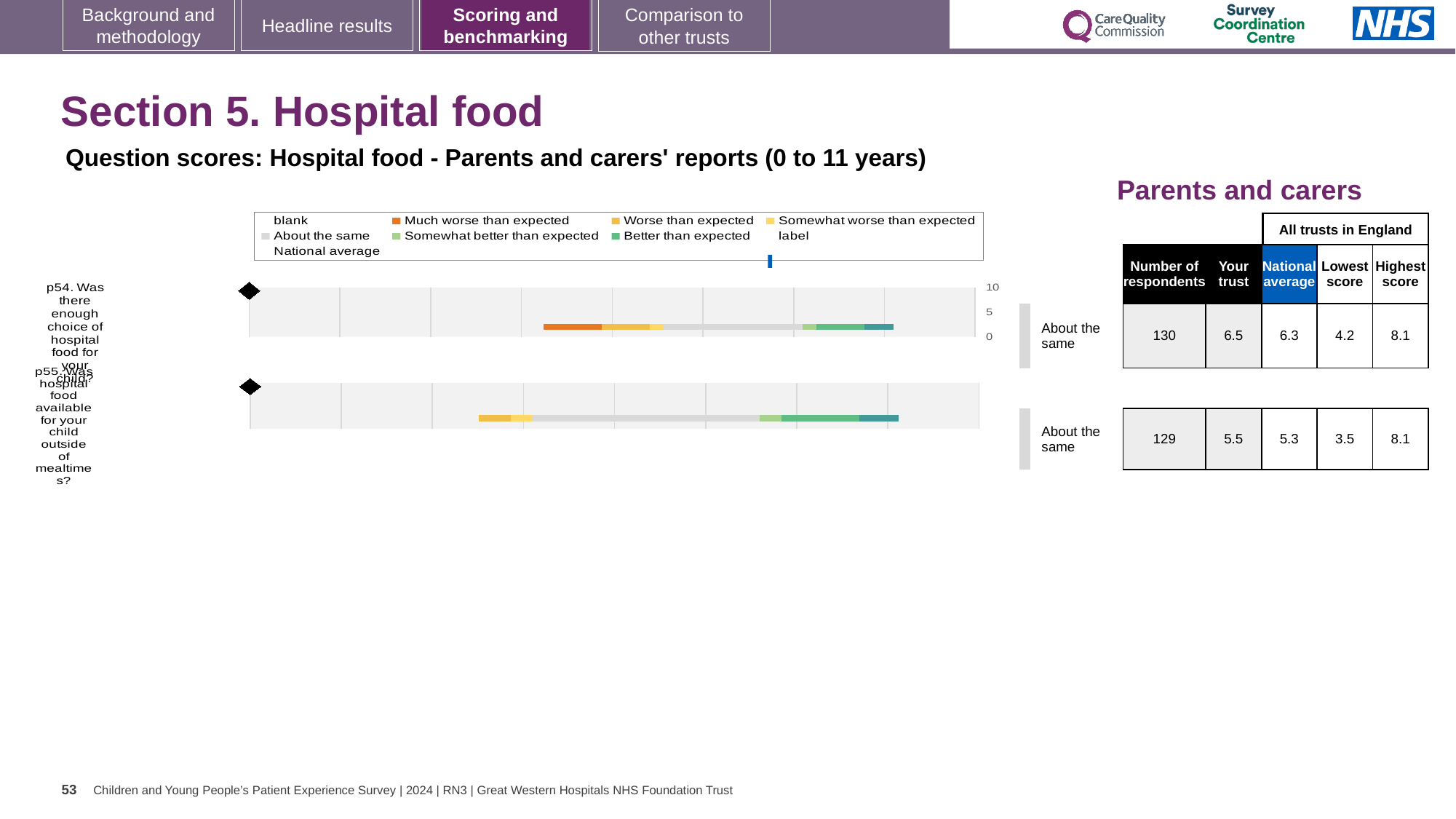
What is the difference between the 'Your trust' score and the national average for p54? 0.2 In the chart legend, what does the blue marker represent? National average What kind of chart is used to show the question scores? bar chart What benchmark category is given for p55? About the same What is the national average score for p55 (hospital food available outside of mealtimes)? 5.3 What is the 'Your trust' score for p54 (enough choice of hospital food)? 6.5 How many survey questions are plotted in the chart? 2 Which legend category is shown in orange? Much worse than expected How many respondents answered p54? 130 What is the lowest score among all trusts in England for p54? 4.2 Which question has the higher 'Your trust' score, p54 or p55? p54 What is the highest score among all trusts in England for p55? 8.1